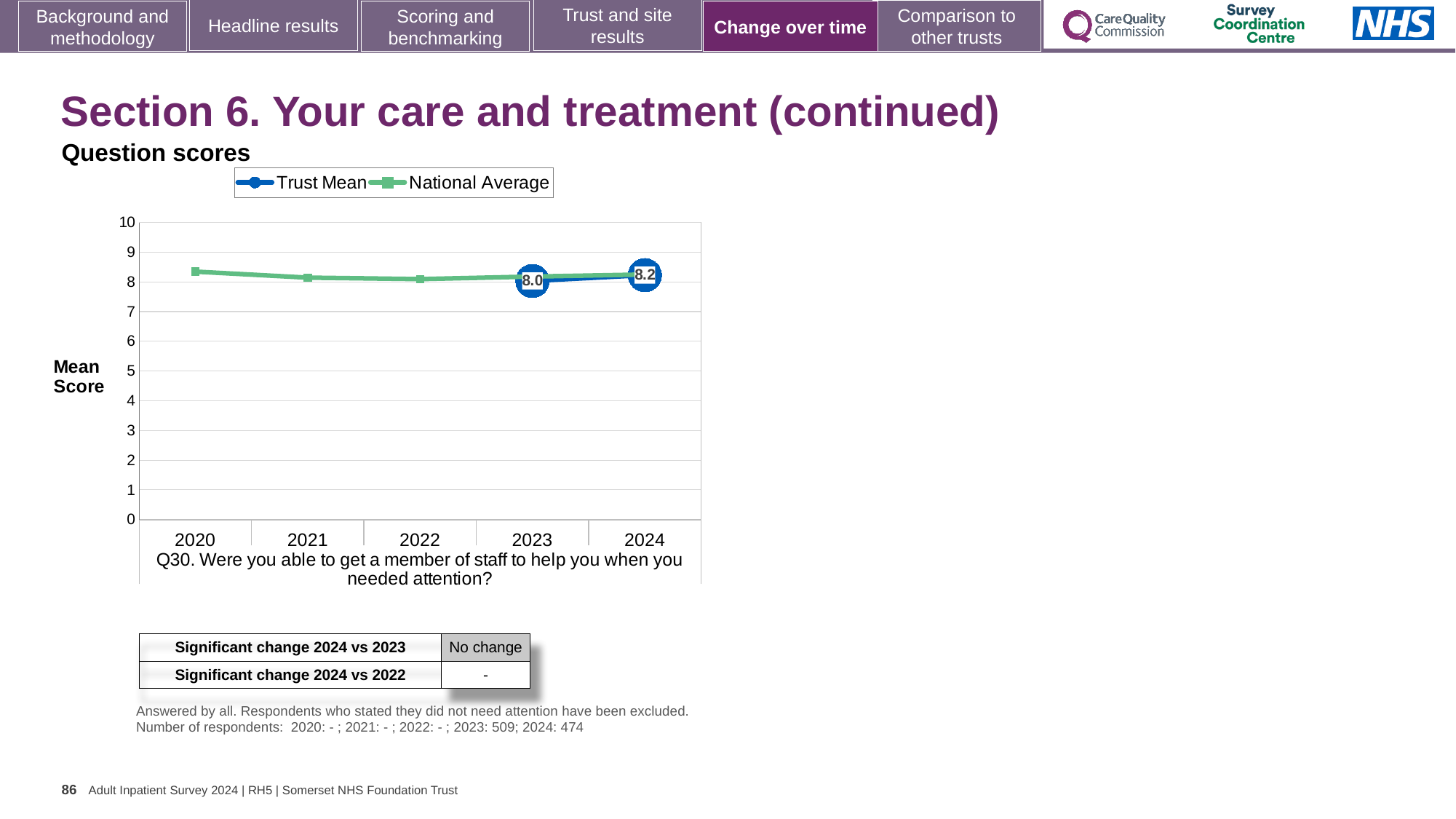
Which year has the higher Trust Mean, 2023 or 2024? 2024 What is the Trust Mean score for 2023? 8.0 Is the National Average for 2020 greater or less than 8? greater How many years are shown on the x axis? 5 Is the National Average for 2021 greater or less than 9? less What kind of chart is shown? line chart Does the Trust Mean rise or fall from 2023 to 2024? rise How many series does the legend list? 2 What is the label on the y axis? Mean Score By how much did the Trust Mean change from 2023 to 2024? 0.2 In which year is the Trust Mean highest? 2024 What is the Trust Mean score for 2024? 8.2